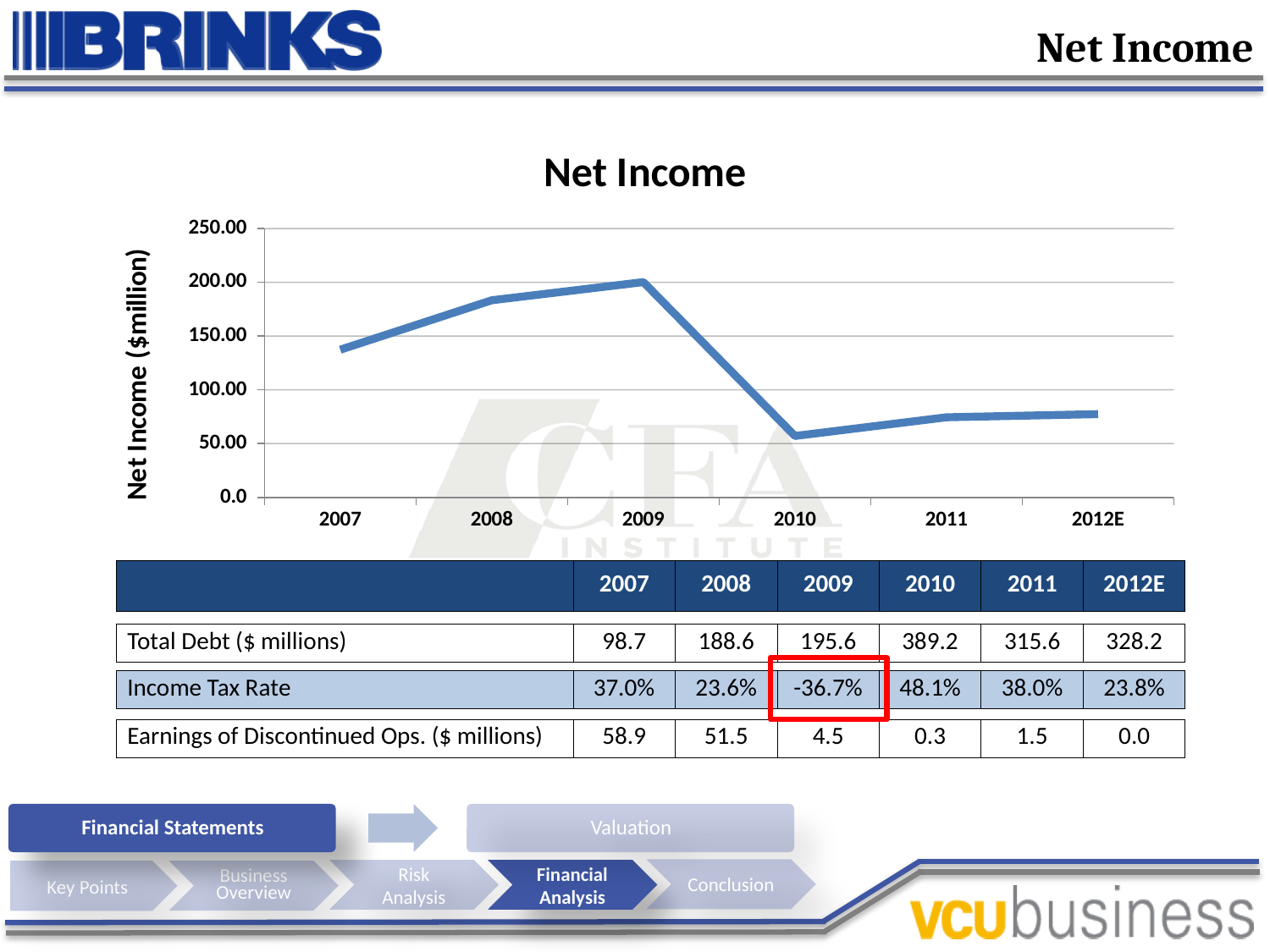
Is the net income value for 2012E greater or less than 100? less Is the net income value for 2010 greater or less than 100? less What kind of chart is shown on the slide? line chart Which year has the highest net income in the chart? 2009 Which year has the lowest net income in the chart? 2010 What is the label on the y axis of the chart? Net Income ($million) Does net income rise or fall from 2009 to 2010? fall How many years are plotted on the x axis of the Net Income chart? 6 Which year has the larger net income, 2007 or 2010? 2007 What is the title of the chart? Net Income Is the net income value for 2007 greater or less than 100? greater